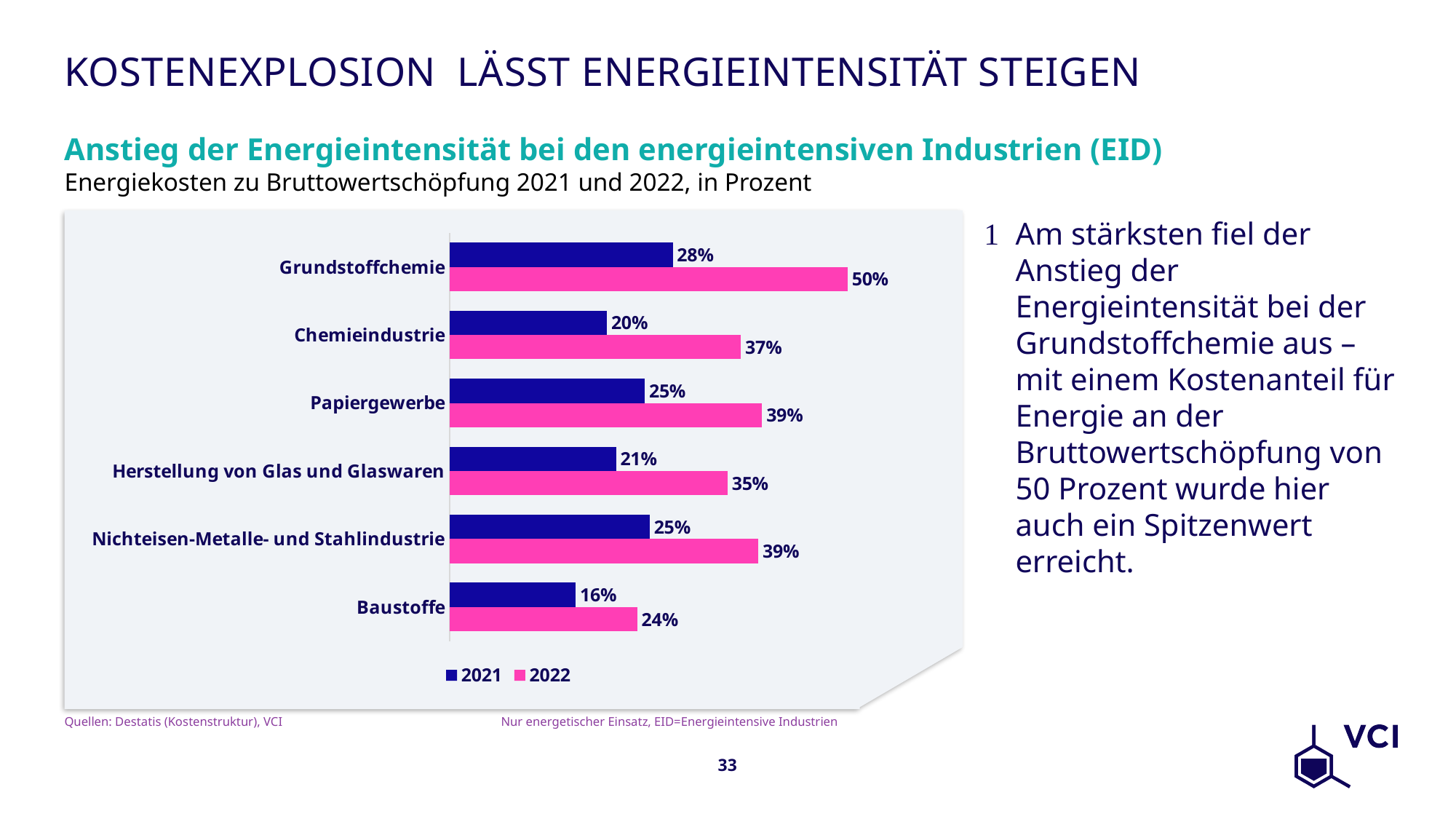
How many categories are shown in the chart? 6 Which series is shown in pink? 2022 What is the 2021 value for Baustoffe? 16% Which category has the highest 2022 value? Grundstoffchemie What kind of chart is shown on the slide? Bar chart What is the 2021 value for Herstellung von Glas und Glaswaren? 21% What is the difference between the 2022 and 2021 values for Chemieindustrie? 17 percentage points What is the title of the chart? Anstieg der Energieintensität bei den energieintensiven Industrien (EID) How many series does the legend list? 2 What is the 2022 value for Grundstoffchemie? 50% Which category has the lowest 2021 value? Baustoffe Which is larger: the 2022 value for Papiergewerbe or the 2022 value for Herstellung von Glas und Glaswaren? Papiergewerbe